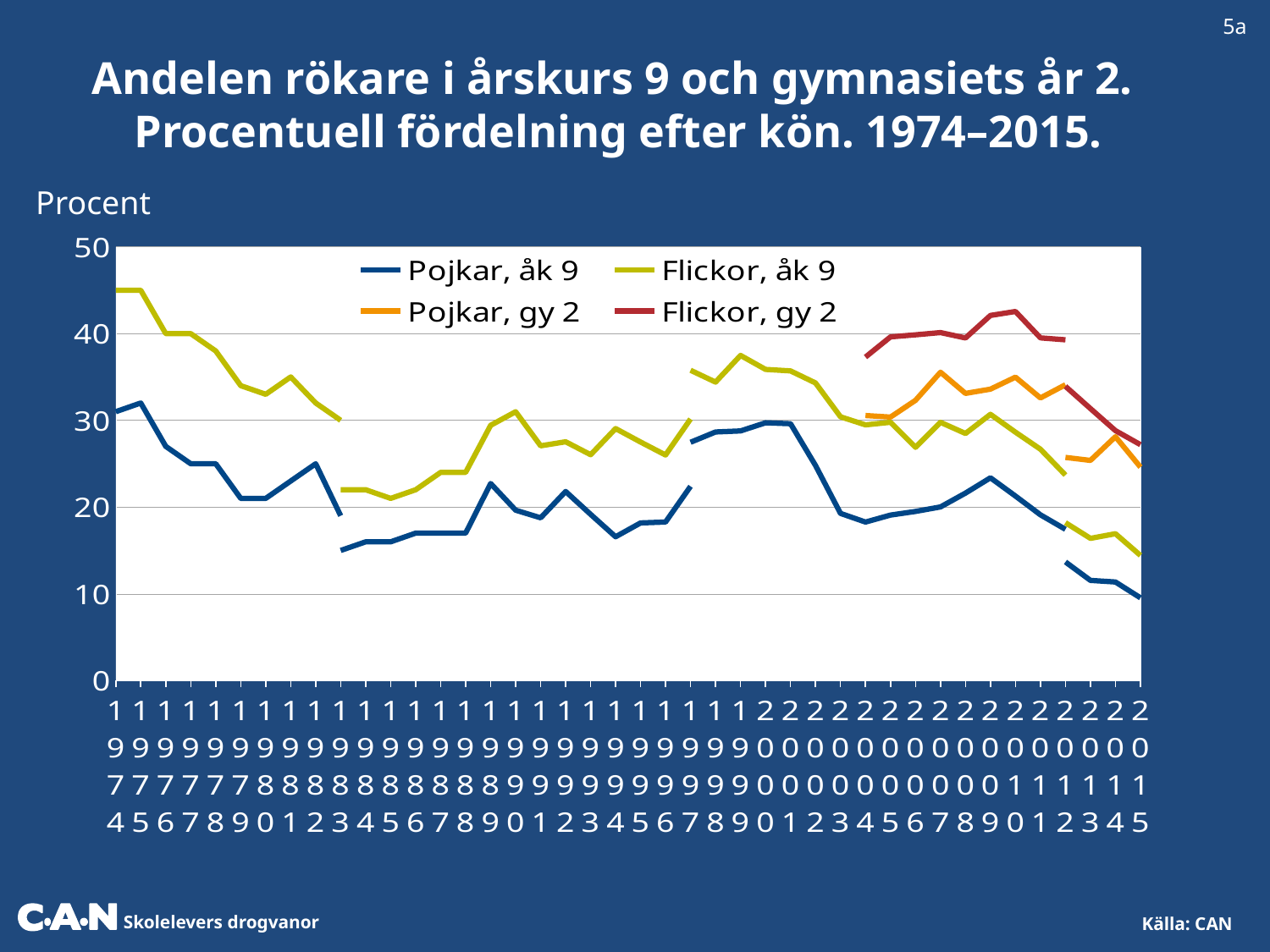
Which series are listed in the chart legend? Pojkar, åk 9; Flickor, åk 9; Pojkar, gy 2; Flickor, gy 2 How many series does the legend list? 4 What is the label on the vertical axis of the chart? Procent How many years are shown along the x axis (1974 to 2015)? 42 Does the Pojkar, åk 9 line rise or fall from 2009 to 2015? fall Is the value for Flickor, gy 2 in 2009 greater or less than 40? greater What kind of chart is shown on the slide? line chart Is the value for Pojkar, gy 2 in 2015 greater or less than 30? less In 1974, which is higher: Flickor, åk 9 or Pojkar, åk 9? Flickor, åk 9 Is the value for Flickor, åk 9 in 1974 greater or less than 40? greater Which series has the lowest value in 2015? Pojkar, åk 9